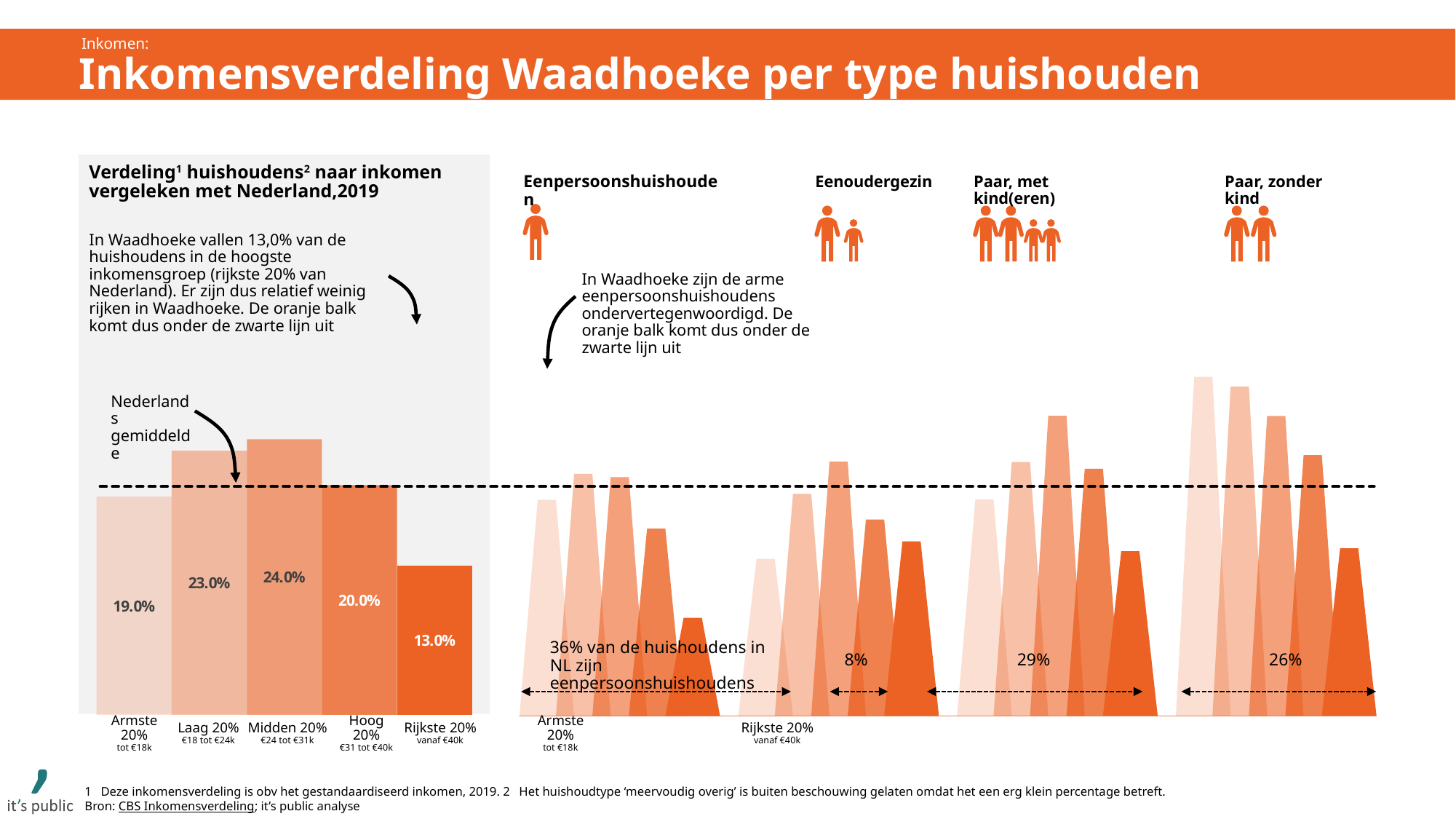
In the left chart, what is the value for Midden 20%? 24.0% In the left chart, which income group has the lowest share of households? Rijkste 20% What does the dashed horizontal line in the left chart represent? Nederlands gemiddelde What kind of chart is the left chart 'Verdeling huishoudens naar inkomen vergeleken met Nederland, 2019'? Bar chart In the left chart 'Verdeling huishoudens naar inkomen vergeleken met Nederland, 2019', what is the value for Rijkste 20%? 13.0% In the left chart, what is the value for Armste 20%? 19.0% In the left chart, which is larger: the value for Laag 20% or the value for Hoog 20%? Laag 20% In the right-hand chart, what percentage is shown for Eenoudergezin? 8% How many income categories are shown in the left chart? 5 In the left chart, which income group has the highest share of households? Midden 20% In the right-hand chart, what percentage of households in NL are eenpersoonshuishoudens? 36% In the left chart, what is the difference between the values for Laag 20% and Rijkste 20%? 10.0%